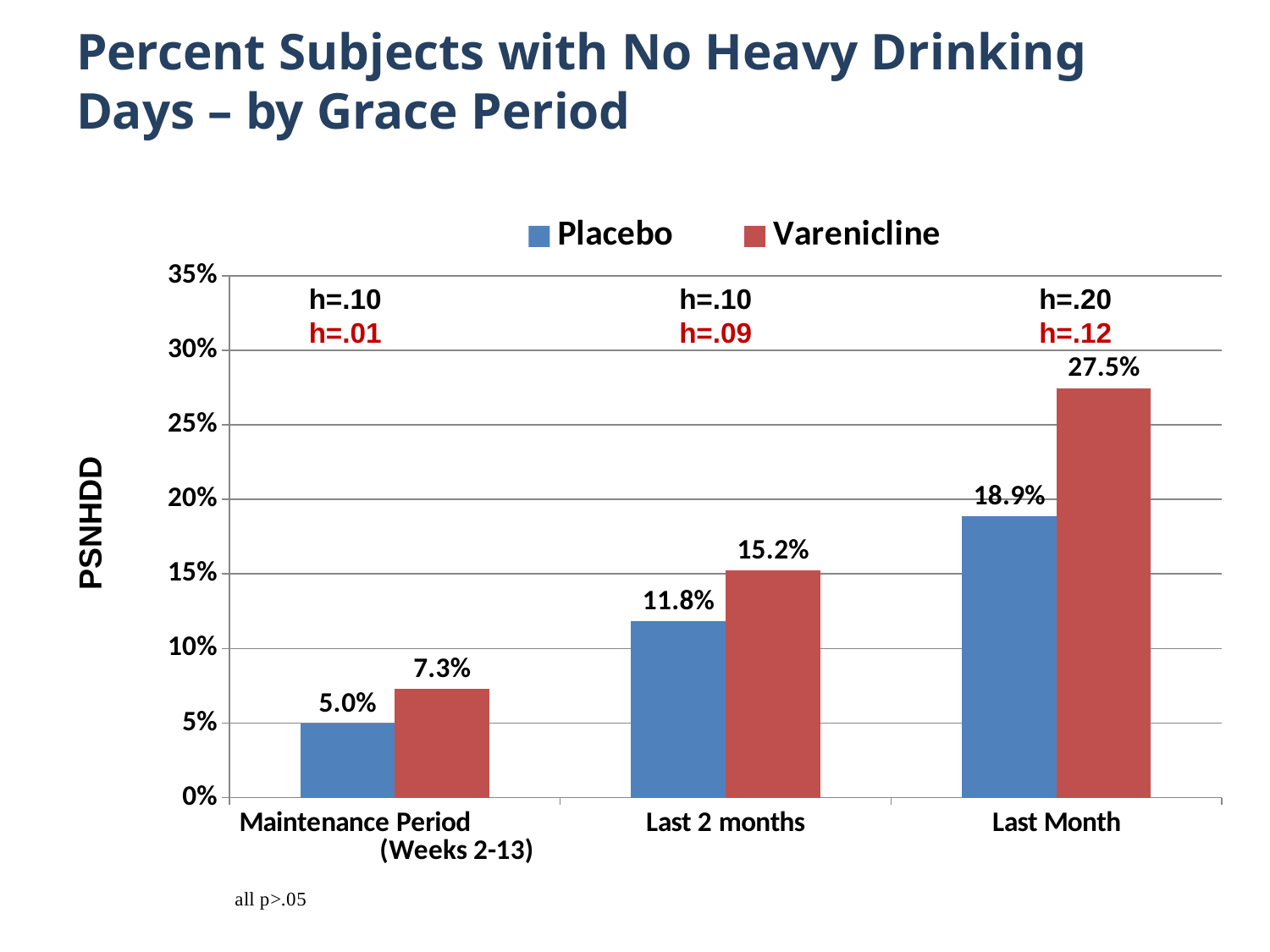
Is the Varenicline value for Last Month greater or less than 25%? greater What is the Varenicline value for Last 2 months? 15.2% How many categories are shown on the x axis? 3 What is the Placebo value for Last Month? 18.9% What kind of chart is shown? bar chart Which category has the highest Varenicline value? Last Month What is the Varenicline value for Maintenance Period (Weeks 2-13)? 7.3% How many series does the legend list? 2 Do the Placebo values rise or fall from Maintenance Period to Last Month? rise For Last 2 months, which is larger, Placebo or Varenicline? Varenicline Which category has the lowest Placebo value? Maintenance Period (Weeks 2-13) What is the difference between the Varenicline and Placebo values for Last Month? 8.6%